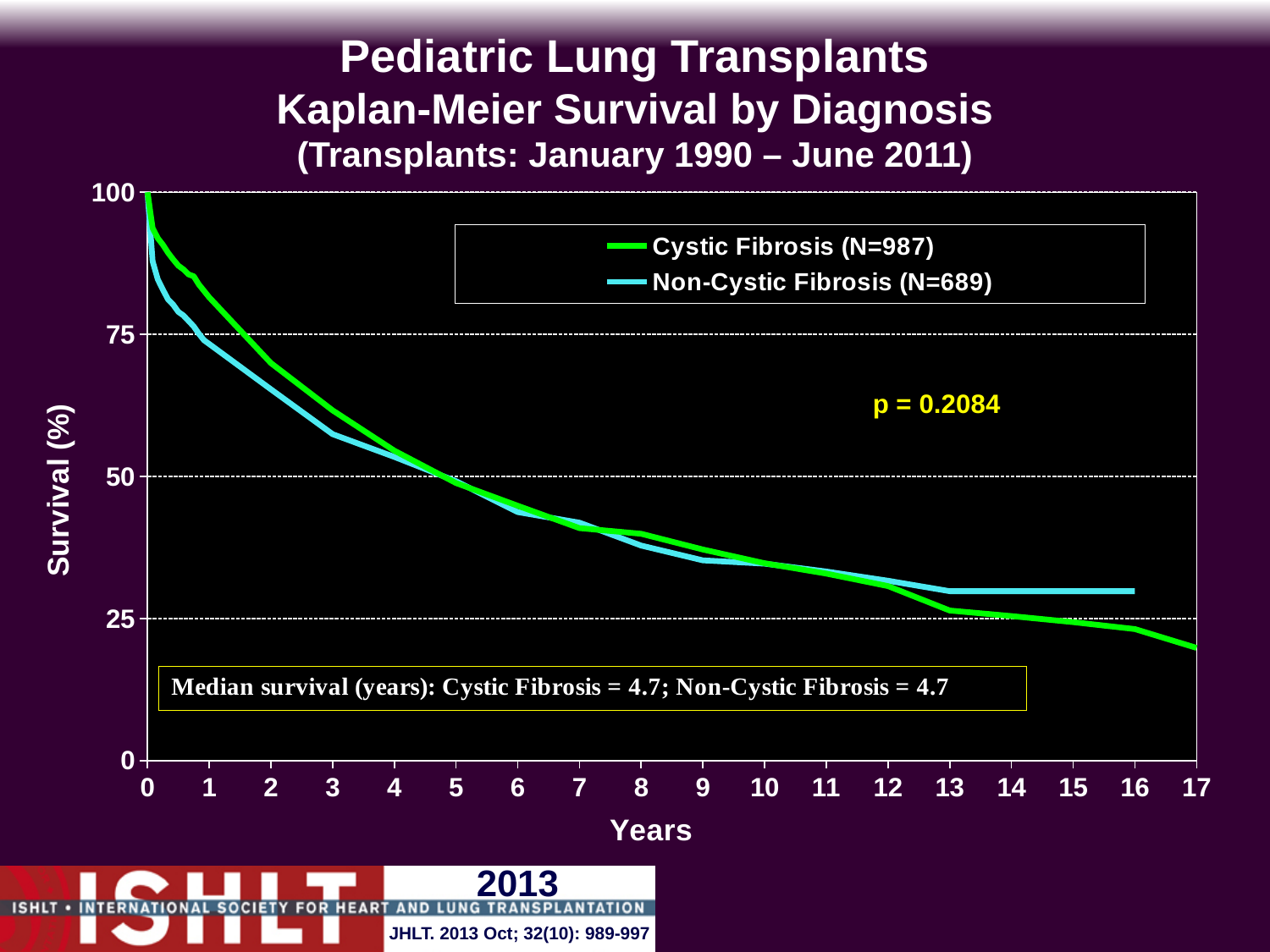
What is the median survival in years for Non-Cystic Fibrosis? 4.7 Is the survival for Cystic Fibrosis at 16 years greater or less than 25? less At 2 years, which group has the higher survival, Cystic Fibrosis or Non-Cystic Fibrosis? Cystic Fibrosis How many series does the legend list? 2 Do the survival curves rise or fall as years increase? fall What is the N for the Non-Cystic Fibrosis group shown in the legend? 689 Is the survival for Cystic Fibrosis at 1 year greater or less than 75? greater What is the median survival in years for Cystic Fibrosis? 4.7 Is the survival for Non-Cystic Fibrosis at 3 years greater or less than 50? greater What p-value is shown on the chart? p = 0.2084 What kind of chart is shown on the slide? line chart What is the N for the Cystic Fibrosis group shown in the legend? 987